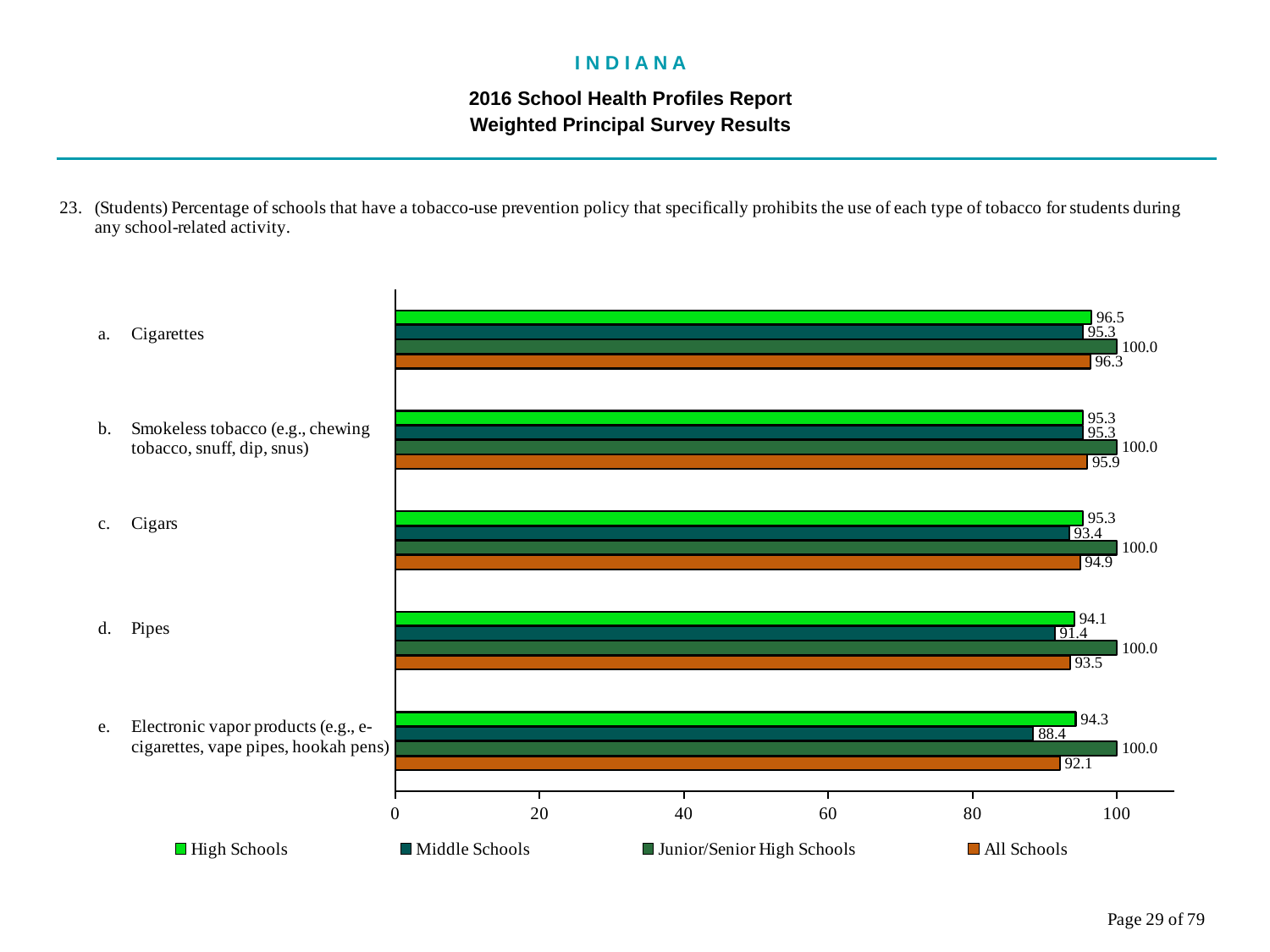
What is the value for High Schools for Cigarettes? 96.5 Which category has the lowest value for Middle Schools? Electronic vapor products What is the value for Middle Schools for Electronic vapor products? 88.4 Which is larger for Pipes: the High Schools value or the Middle Schools value? High Schools How many series does the legend list? 4 What is the value for Junior/Senior High Schools for Cigars? 100.0 What kind of chart is shown on the slide? Bar chart What is the difference between the High Schools and Middle Schools values for Electronic vapor products? 5.9 What is the value for All Schools for Pipes? 93.5 Which series is shown in orange in the legend? All Schools Which category has the highest value for All Schools? Cigarettes How many categories are shown in the chart? 5